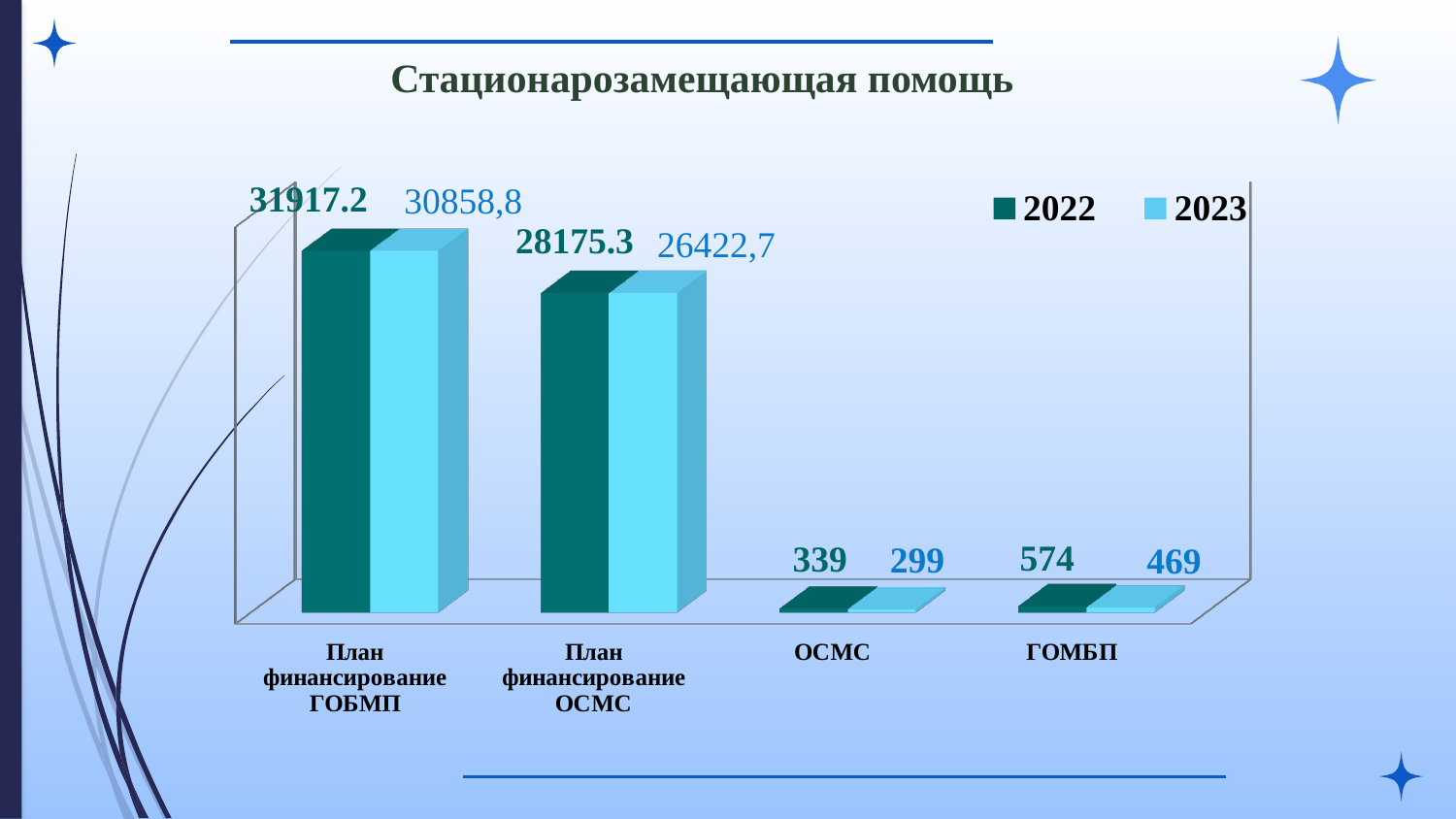
Which category has the lowest 2023 value? ОСМС What is the 2023 value for План финансирование ОСМС? 26422,7 How many series does the legend list? 2 What is the difference between the 2022 and 2023 values for ГОМБП? 105 What is the 2022 value for ОСМС? 339 What is the 2023 value for ГОМБП? 469 Which is larger for ГОМБП: the 2022 value or the 2023 value? 2022 What type of chart is shown on the slide? Bar chart Which category has the highest 2022 value? План финансирование ГОБМП What is the difference between the 2022 and 2023 values for ОСМС? 40 What is the 2022 value for План финансирование ГОБМП? 31917.2 How many categories are shown on the x axis? 4